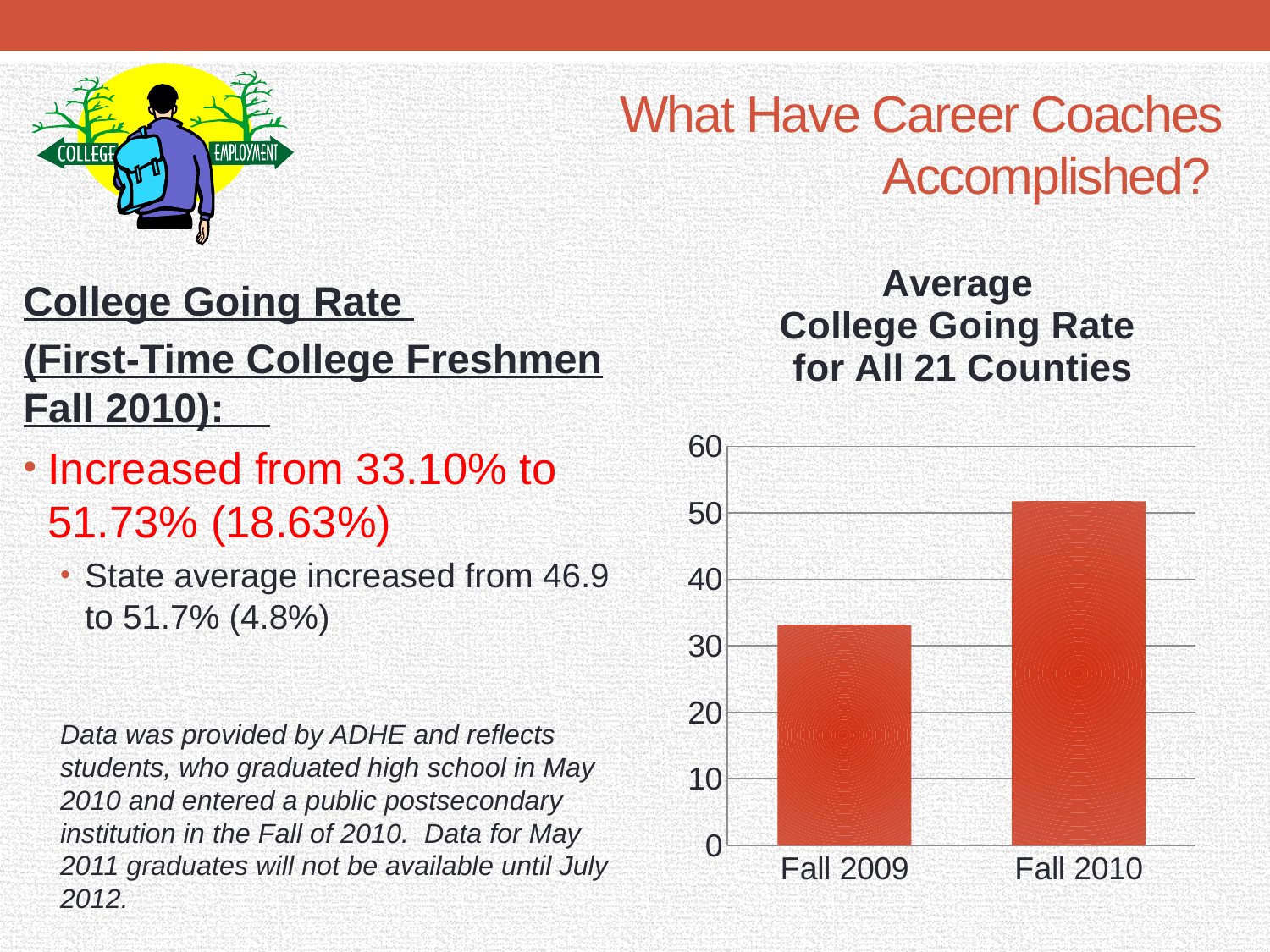
Is the value for Fall 2009 greater or less than 40? less Is the value for Fall 2010 greater or less than 60? less Which category has the lowest bar in the chart? Fall 2009 What is the title of the chart? Average College Going Rate for All 21 Counties What is the highest value shown on the chart's vertical axis? 60 Which is larger, the bar for Fall 2009 or the bar for Fall 2010? Fall 2010 What kind of chart is shown on the slide? bar chart How many bars are plotted in the chart? 2 Which category has the highest bar in the chart? Fall 2010 Do the values rise or fall from Fall 2009 to Fall 2010? rise Is the value for Fall 2010 greater or less than 50? greater